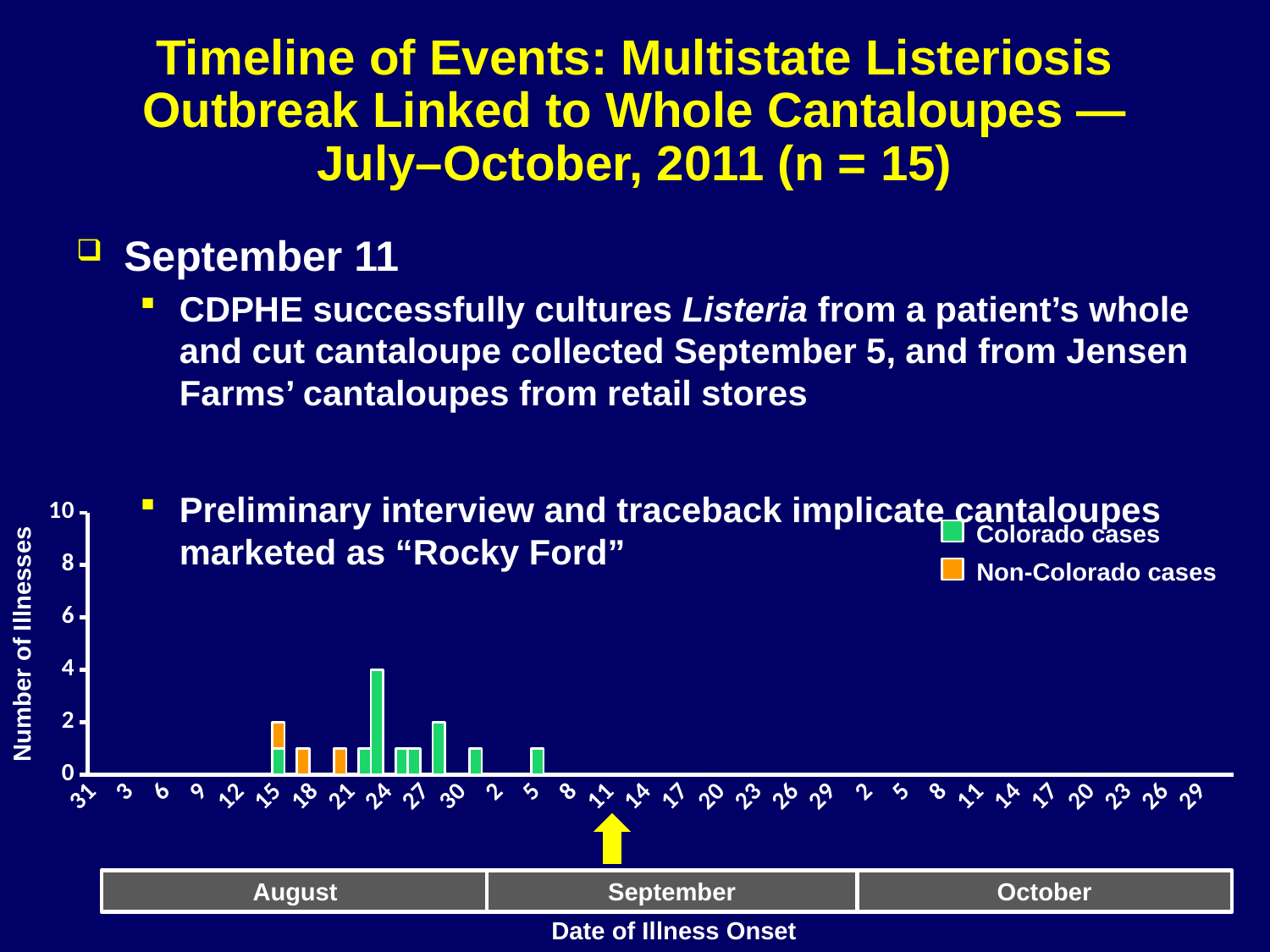
What colour represents Colorado cases in the chart? green How many series does the chart legend list? 2 Is the tallest bar in the chart greater or less than 2 illnesses? greater Is the tallest bar in the chart greater or less than 6 illnesses? less What are the two series named in the chart legend? Colorado cases and Non-Colorado cases What is the highest number of illnesses recorded on a single onset date in the chart? 4 Are any illnesses plotted with an onset date in October? No Which month has the most illness onset dates with cases in the chart: August, September or October? August What kind of chart is shown on the slide? bar chart What is the maximum value shown on the vertical axis of the chart? 10